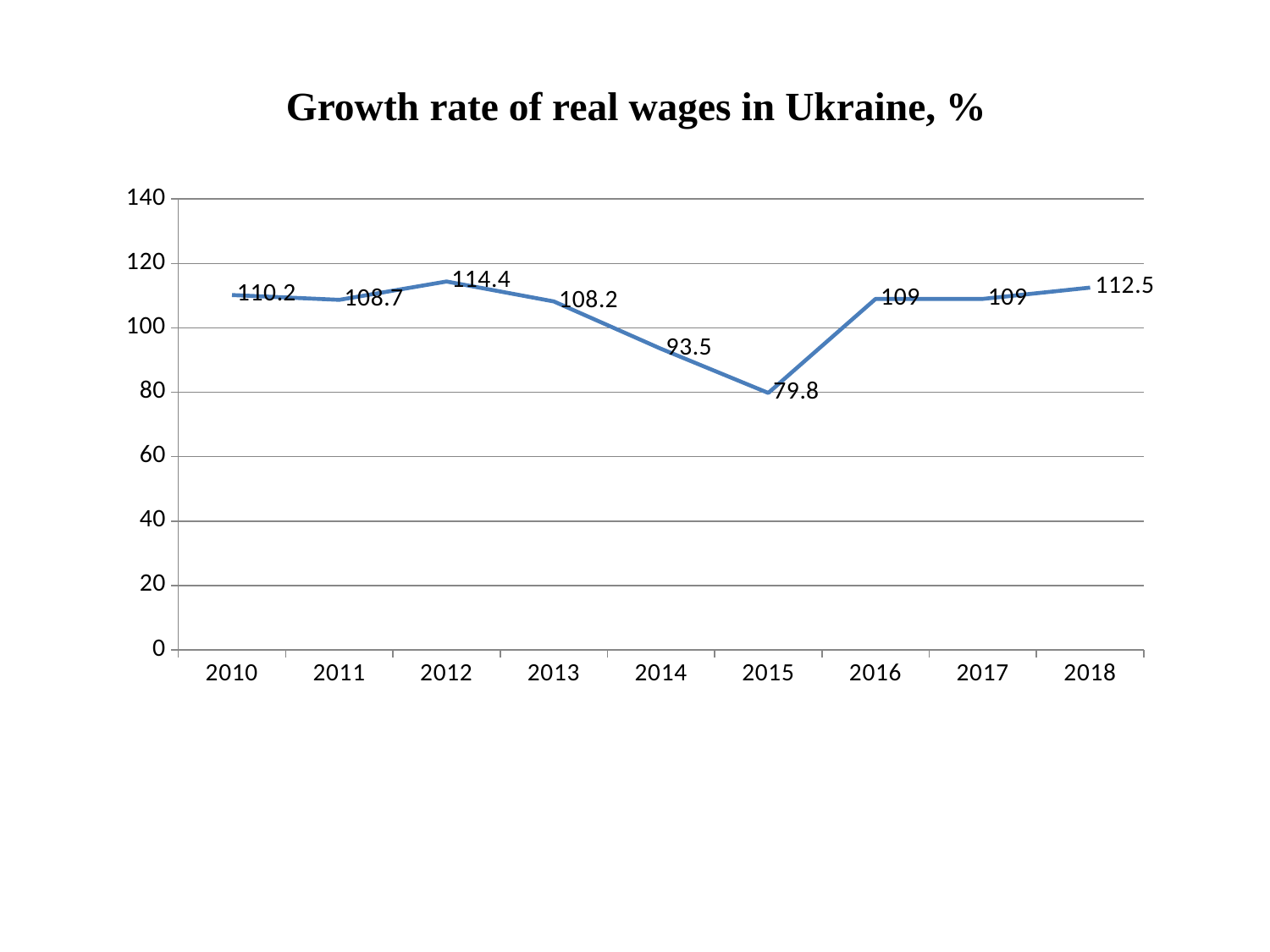
What is the growth rate of real wages in Ukraine for 2012? 114.4 What is the value shown for 2015? 79.8 Is the value for 2014 greater or less than 100? less Which year has the lowest growth rate of real wages? 2015 What is the value shown for 2018? 112.5 What kind of chart is shown on the slide? line chart How many years are plotted on the chart? 9 What is the difference between the values for 2018 and 2017? 3.5 Which year has a larger value, 2010 or 2014? 2010 What is the difference between the values for 2012 and 2015? 34.6 Which year has the highest growth rate of real wages? 2012 Do the values rise or fall from 2013 to 2015? fall